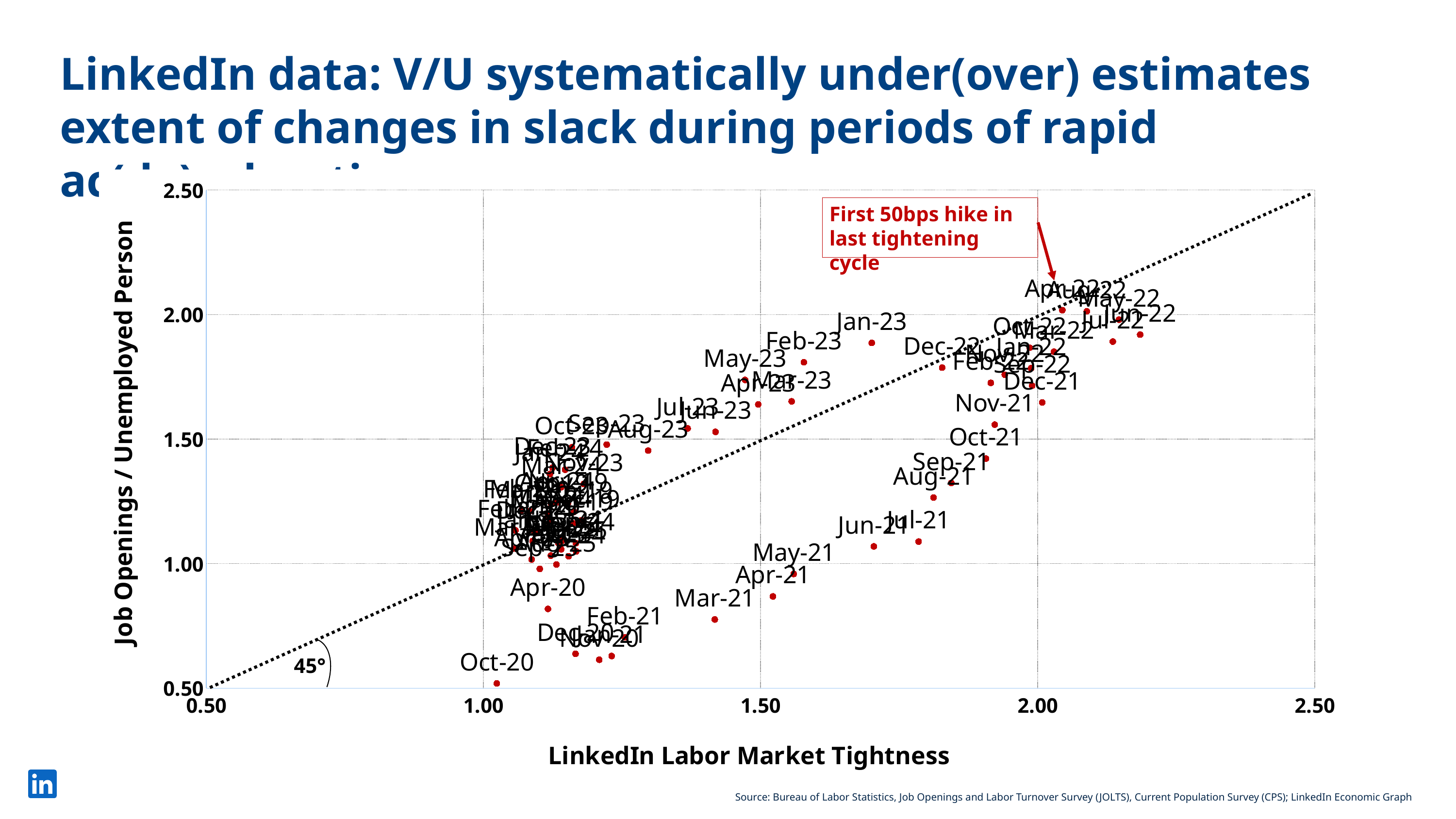
Is the Job Openings / Unemployed Person value for Feb-23 greater or less than 1.50? greater Is the Job Openings / Unemployed Person value for Oct-20 greater or less than 1.00? less Is the Job Openings / Unemployed Person value for Jan-23 greater or less than 2.00? less What is the label of the y axis? Job Openings / Unemployed Person What kind of chart is shown on the slide? scatter chart Which has the higher Job Openings / Unemployed Person value, Jan-23 or Mar-21? Jan-23 What is the label of the x axis? LinkedIn Labor Market Tightness Which has the higher Job Openings / Unemployed Person value, Oct-20 or Apr-20? Apr-20